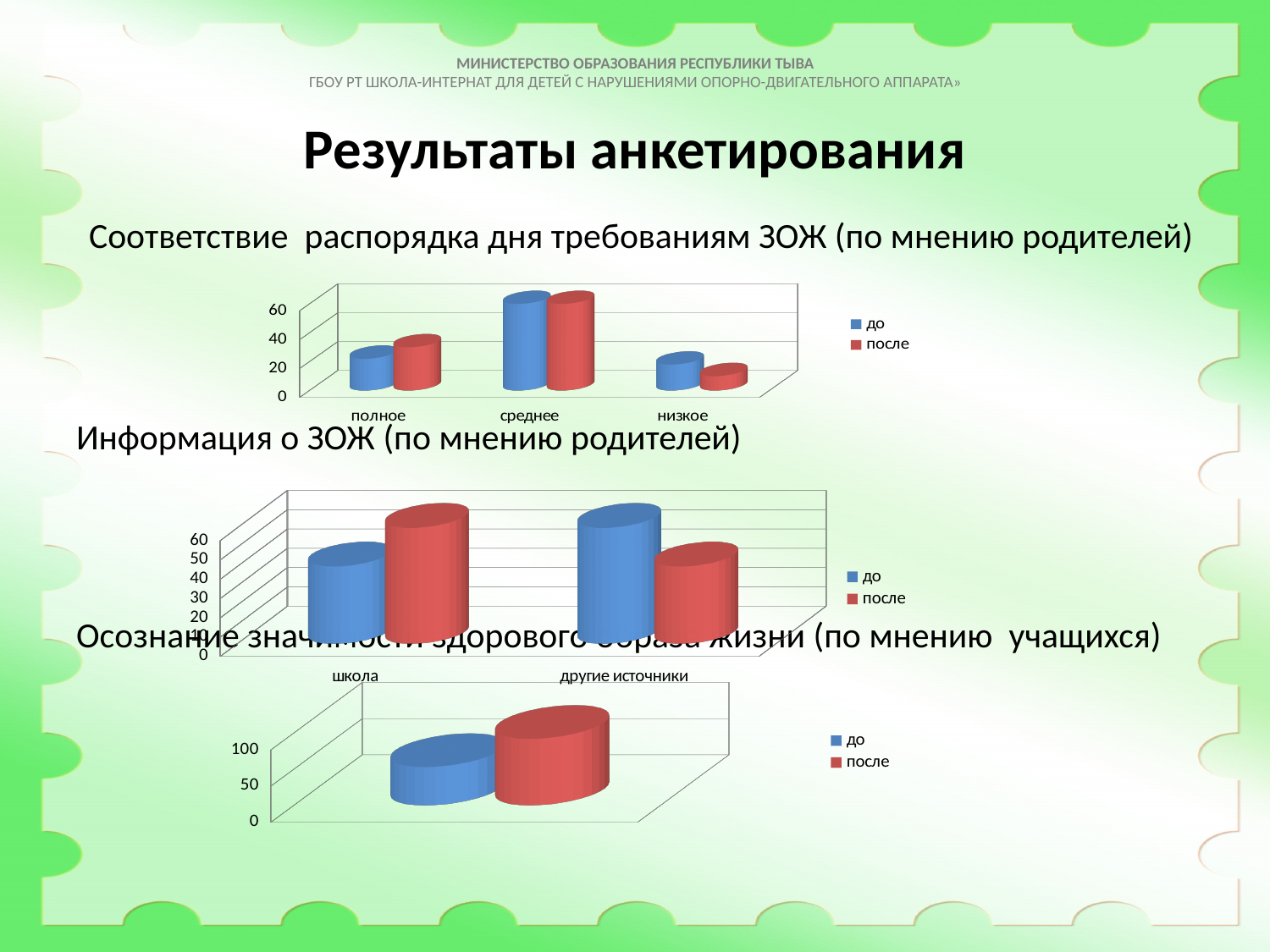
On the chart 'Соответствие распорядка дня требованиям ЗОЖ (по мнению родителей)', is the 'до' value for 'среднее' greater or less than 40? greater On the chart 'Соответствие распорядка дня требованиям ЗОЖ (по мнению родителей)', is the 'после' value for 'низкое' greater or less than 20? less On the chart 'Соответствие распорядка дня требованиям ЗОЖ (по мнению родителей)', for 'полное', which series is larger, 'до' or 'после'? после How many categories are shown on the chart 'Соответствие распорядка дня требованиям ЗОЖ (по мнению родителей)'? 3 On the chart 'Информация о ЗОЖ (по мнению родителей)', for 'школа', which series is larger, 'до' or 'после'? после How many series does the legend list on the chart 'Информация о ЗОЖ (по мнению родителей)'? 2 What kind of chart is the bottom chart 'Осознание значимости здорового образа жизни (по мнению учащихся)'? bar chart On the bottom chart 'Осознание значимости здорового образа жизни (по мнению учащихся)', which series is larger, 'до' or 'после'? после How many categories are shown on the chart 'Информация о ЗОЖ (по мнению родителей)'? 2 On the chart 'Соответствие распорядка дня требованиям ЗОЖ (по мнению родителей)', which category has the lowest value for the 'после' series? низкое On the chart 'Соответствие распорядка дня требованиям ЗОЖ (по мнению родителей)', which category has the highest value for the 'до' series? среднее